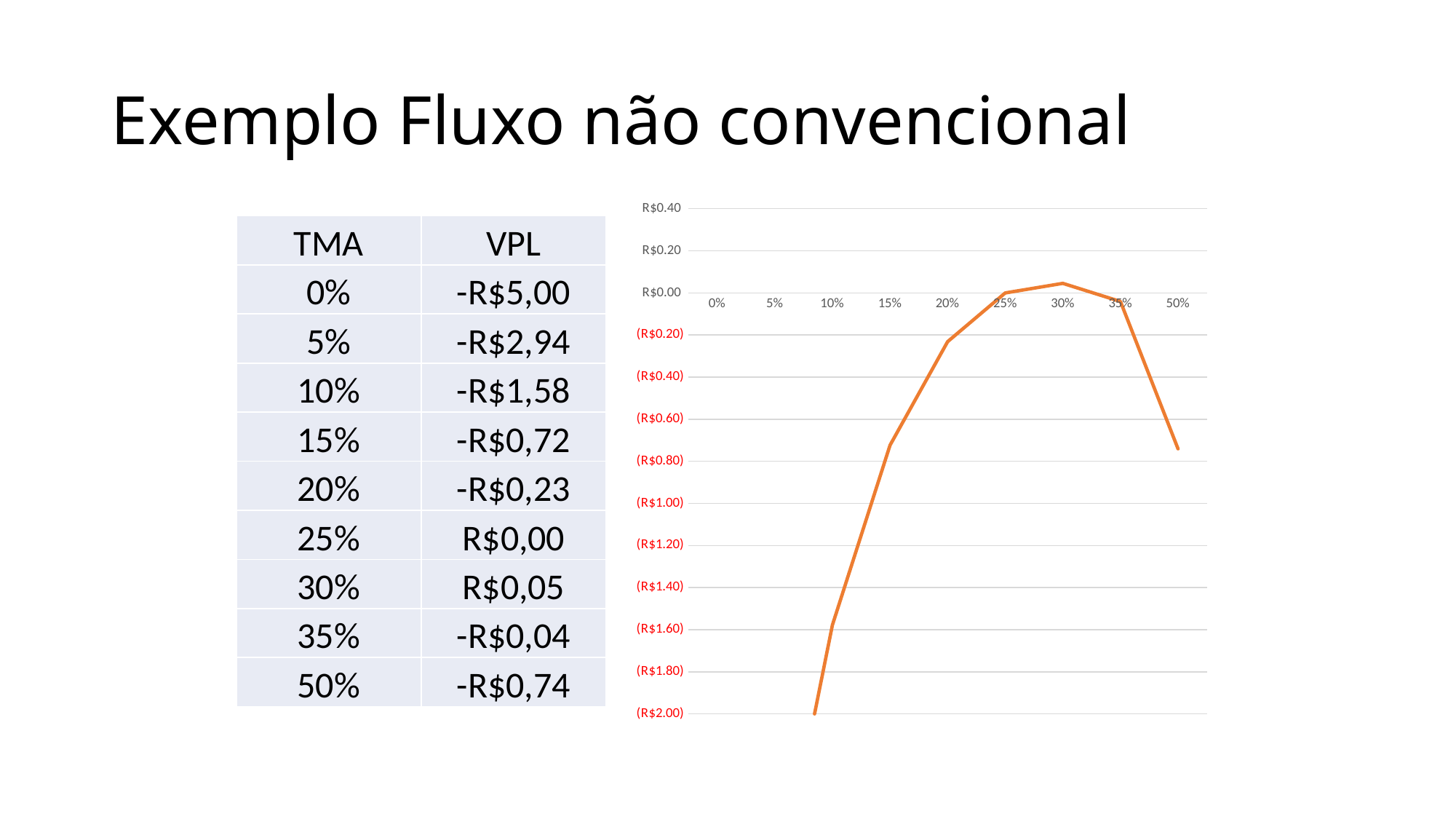
Does the line rise or fall between 10% and 30% on the x axis? rises Is the VPL value plotted at 20% greater or less than (R$0.40)? greater Is the VPL value plotted at 10% greater or less than (R$1.40)? less How many TMA categories are labelled along the x axis of the chart? 9 According to the table on the slide, what is the VPL at a TMA of 30%? R$0,05 Is the VPL value plotted at 50% greater or less than (R$0.60)? less At which TMA does the line reach its highest VPL value? 30% What colour is the line plotted on the chart? orange Which has the larger VPL on the chart, 25% or 50%? 25% Does the line rise or fall between 30% and 50% on the x axis? falls What kind of chart is shown on the slide? line chart